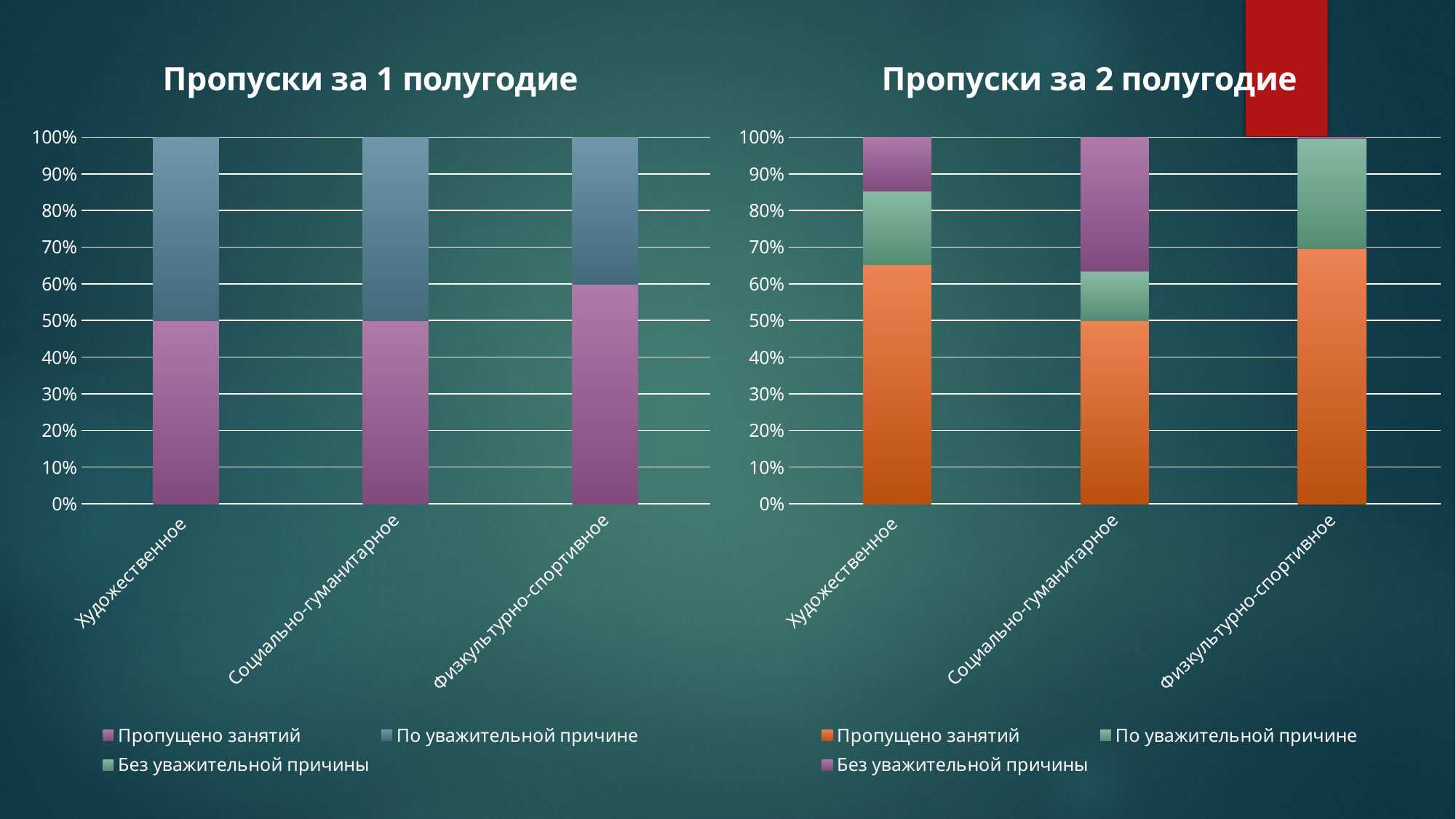
What is the title of the chart on the right side of the slide? Пропуски за 2 полугодие What kind of chart is "Пропуски за 1 полугодие"? bar chart How many series does the legend of "Пропуски за 1 полугодие" list? 3 In "Пропуски за 2 полугодие", which category has the smallest "Без уважительной причины" segment? Физкультурно-спортивное In "Пропуски за 1 полугодие", is the "Пропущено занятий" segment larger for Физкультурно-спортивное or for Художественное? Физкультурно-спортивное In "Пропуски за 1 полугодие", what is the value of "Пропущено занятий" for Физкультурно-спортивное? 60% How many categories are shown on the x axis of "Пропуски за 2 полугодие"? 3 In "Пропуски за 1 полугодие", what is the value of "Пропущено занятий" for Художественное? 50% In "Пропуски за 2 полугодие", is the value of "Пропущено занятий" for Художественное greater or less than 60%? greater In "Пропуски за 2 полугодие", which category has the largest "Без уважительной причины" segment? Социально-гуманитарное In "Пропуски за 2 полугодие", what is the value of "Пропущено занятий" for Социально-гуманитарное? 50%